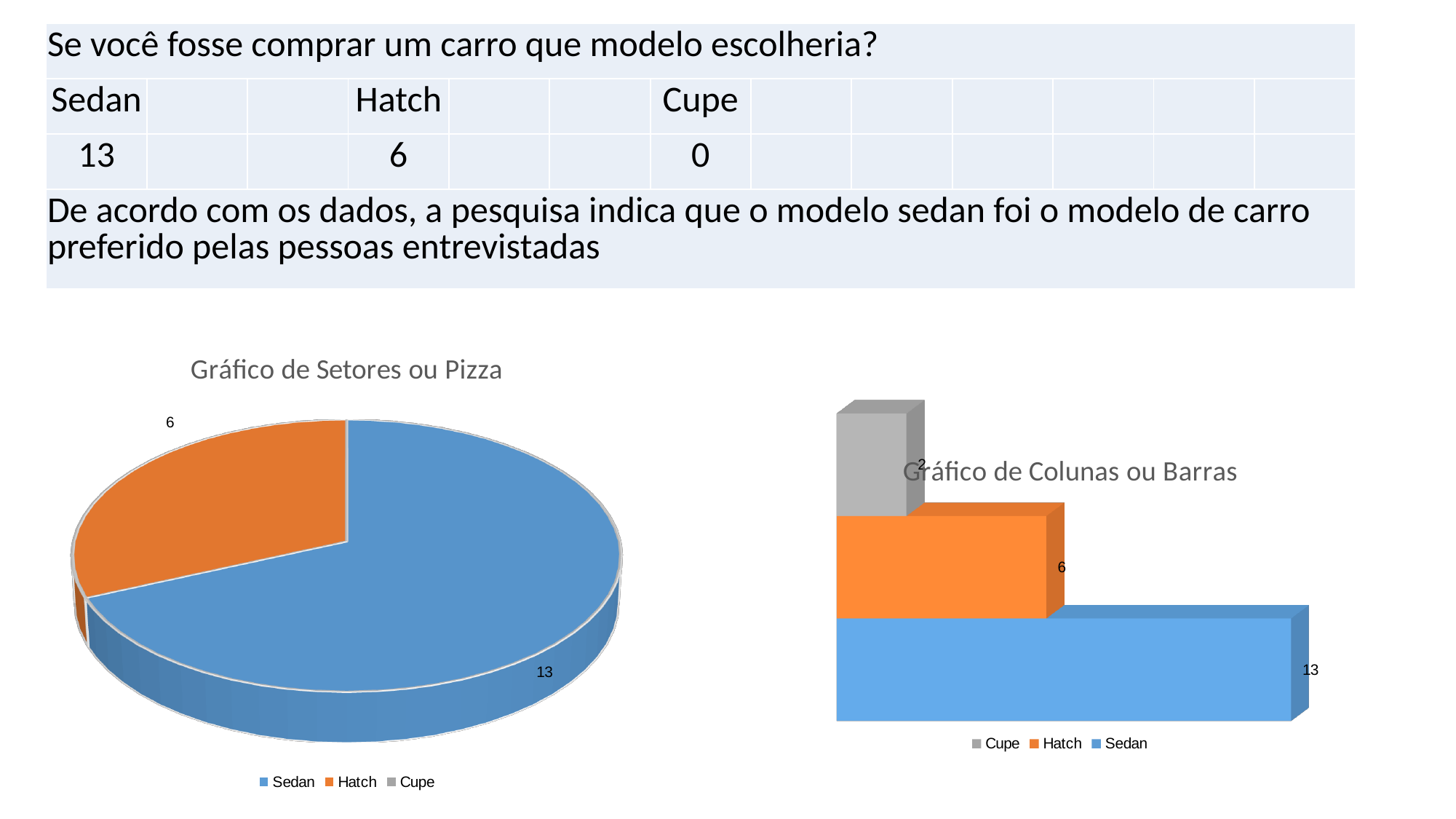
In the bar chart titled "Gráfico de Colunas ou Barras", what value is shown for Hatch? 6 In the pie chart titled "Gráfico de Setores ou Pizza", what value is shown for Hatch? 6 What kind of chart is the one on the right of the slide, titled "Gráfico de Colunas ou Barras"? bar chart In the pie chart titled "Gráfico de Setores ou Pizza", what value is shown for Sedan? 13 How many entries does the legend of the pie chart titled "Gráfico de Setores ou Pizza" list? 3 What kind of chart is the one on the left of the slide, titled "Gráfico de Setores ou Pizza"? pie chart In the pie chart titled "Gráfico de Setores ou Pizza", which category has the largest slice? Sedan In the bar chart titled "Gráfico de Colunas ou Barras", which category has the shortest bar? Cupe In the bar chart titled "Gráfico de Colunas ou Barras", what value is shown for Sedan? 13 In the bar chart titled "Gráfico de Colunas ou Barras", which category has the longest bar? Sedan In the pie chart titled "Gráfico de Setores ou Pizza", what is the difference between the Sedan value and the Hatch value? 7 In the bar chart titled "Gráfico de Colunas ou Barras", which is larger, the bar for Hatch or the bar for Cupe? Hatch